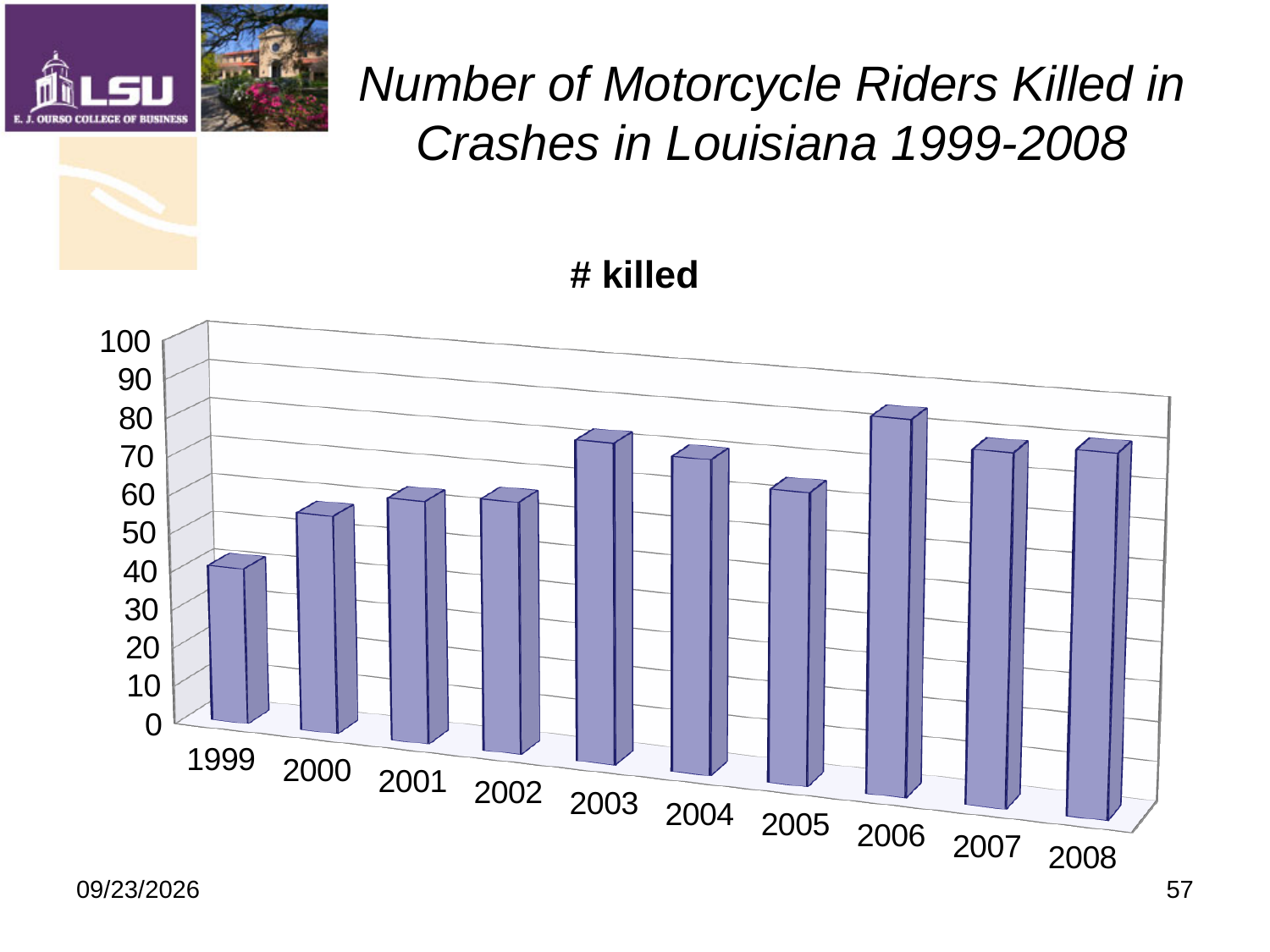
Which year has the highest number of motorcycle riders killed? 2006 Is the value for 2000 greater or less than 70? less What is the title shown above the chart? # killed Is the value for 1999 greater or less than 50? less Do the values generally rise or fall from 1999 to 2006? rise How many years are plotted on the chart? 10 Is the value for 2006 greater or less than 70? greater What kind of chart is shown on the slide? bar chart Which year has the lowest number of motorcycle riders killed? 1999 Which year has the larger value, 1999 or 2006? 2006 Which year has the larger value, 2003 or 2005? 2003